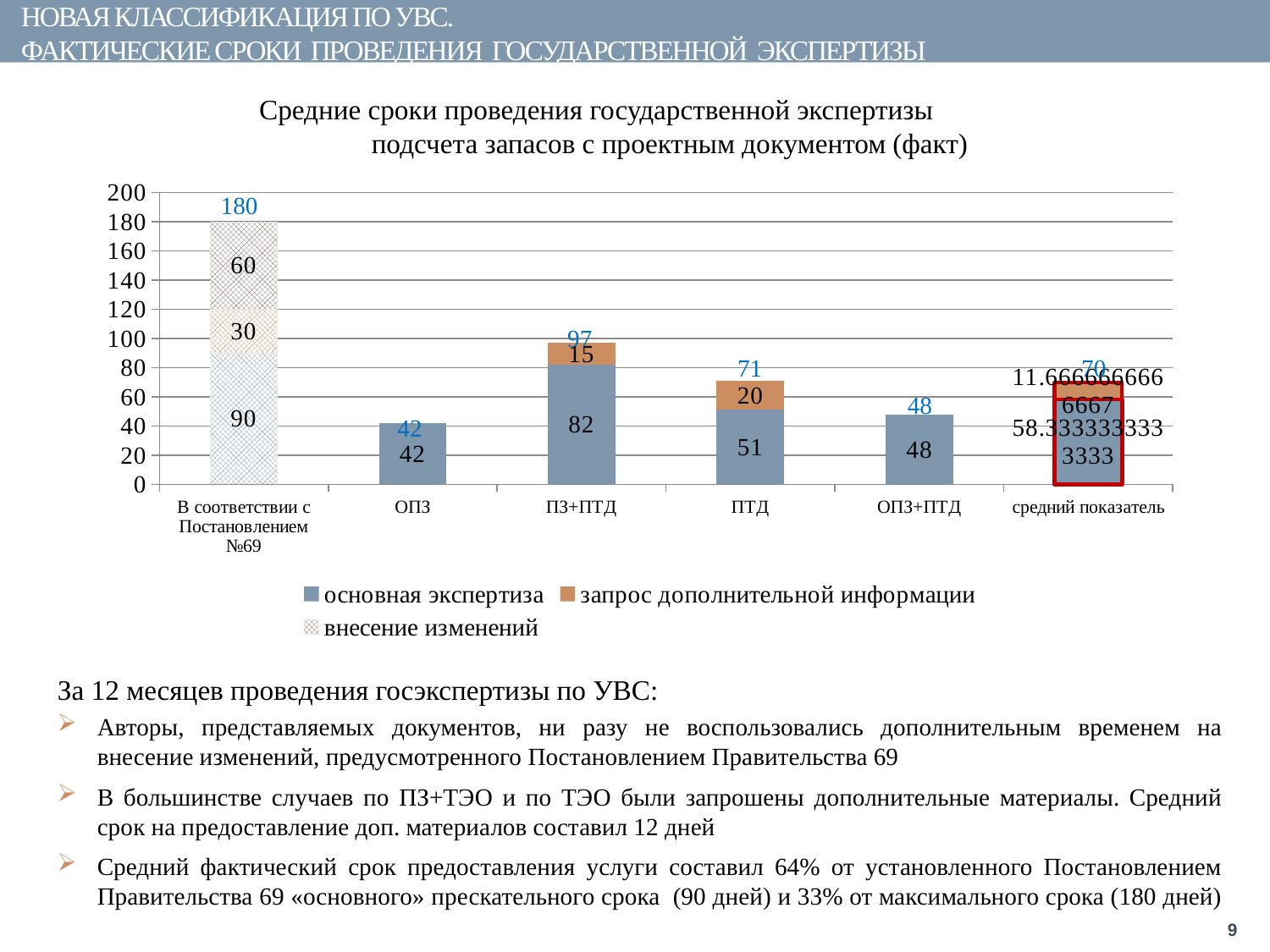
What is the total of the stacked bar for 'В соответствии с Постановлением №69'? 180 Which category has the highest total? В соответствии с Постановлением №69 Which is larger: the 'основная экспертиза' value for ПТД or for ОПЗ+ПТД? ПТД What is the value of 'внесение изменений' for 'В соответствии с Постановлением №69'? 60 What kind of chart is shown on the slide? stacked bar chart What is the value of 'запрос дополнительной информации' for ПТД? 20 What is the difference between the totals for ПЗ+ПТД and ОПЗ+ПТД? 49 What is the value of 'основная экспертиза' for ПЗ+ПТД? 82 Which category has the lowest total? ОПЗ How many categories are shown on the x axis? 6 How many series does the legend list? 3 What is the total of the stacked bar for ПТД? 71